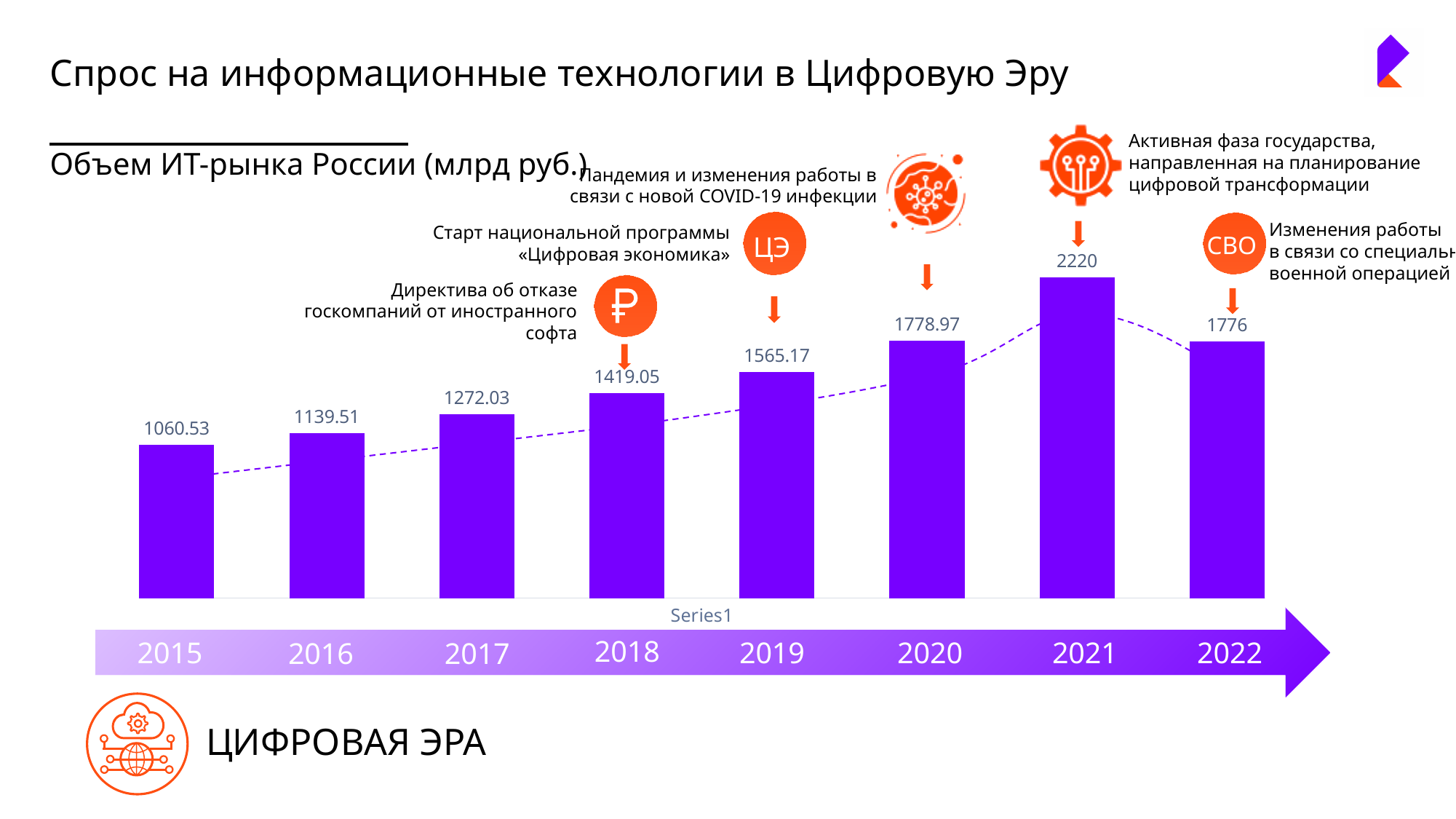
Which year has the lowest value? 2015 What is the difference between the values for 2021 and 2022? 444 How many years are shown on the chart? 8 What is the value for 2015? 1060.53 What is the value for 2019? 1565.17 What is the value for 2022? 1776 Which year has the highest value? 2021 What kind of chart is this? bar chart What is the title of the chart? Объем ИТ-рынка России (млрд руб.) What is the difference between the values for 2020 and 2019? 213.8 Which is larger, the value for 2020 or the value for 2022? 2020 Do the values rise or fall from 2015 to 2021? rise